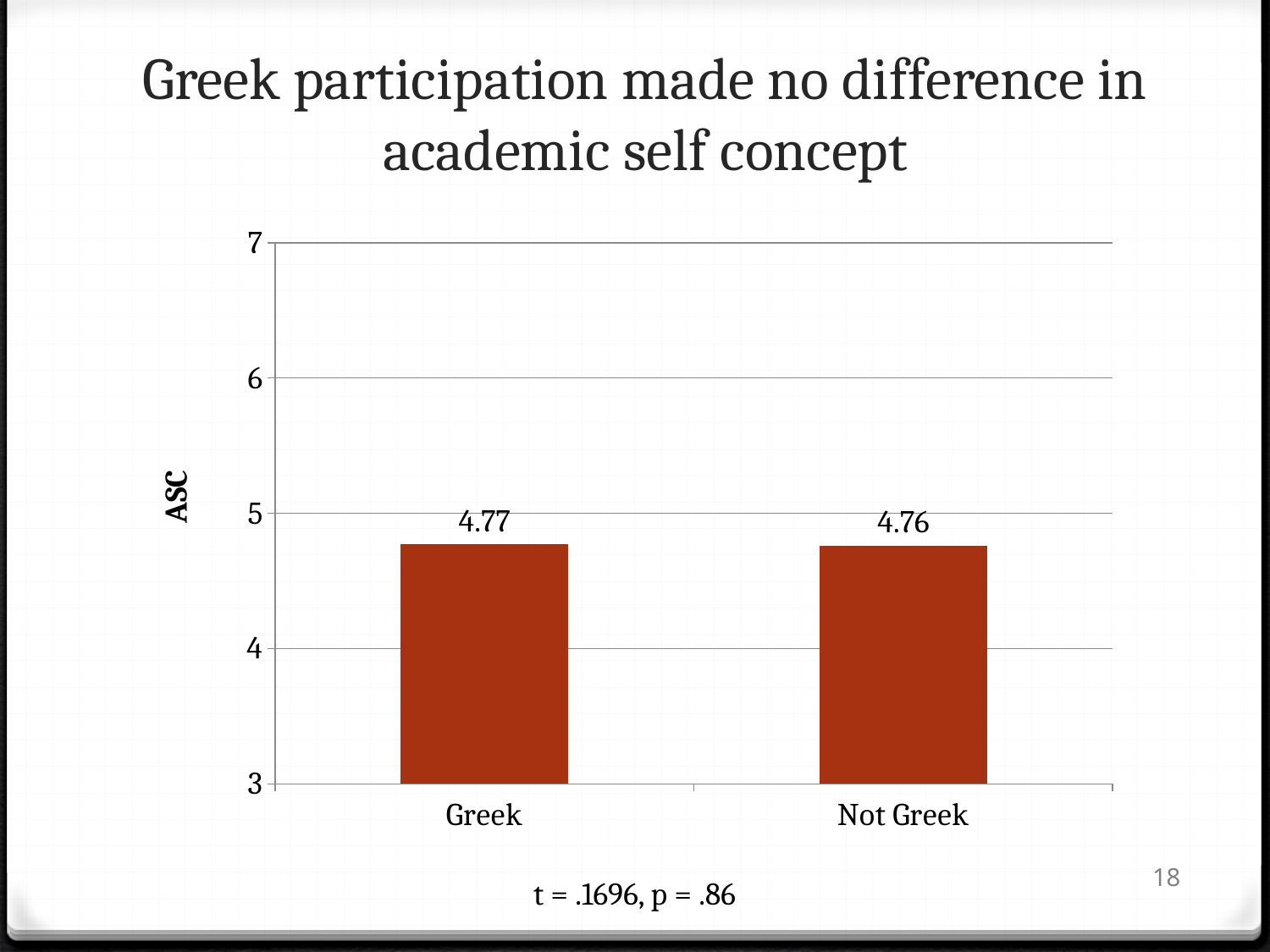
How many categories are shown on the x axis? 2 What is the title of the slide? Greek participation made no difference in academic self concept What is the ASC value for Not Greek? 4.76 What is the difference between the ASC values for Greek and Not Greek? 0.01 What is the label of the y axis? ASC Which category has the higher ASC value according to the data labels? Greek Is the ASC value for Not Greek greater or less than 4? greater Is the ASC value for Greek greater or less than 5? less Which category has the lower ASC value according to the data labels? Not Greek What is the highest value shown on the y axis? 7 What kind of chart is shown on the slide? bar chart What is the ASC value for Greek? 4.77